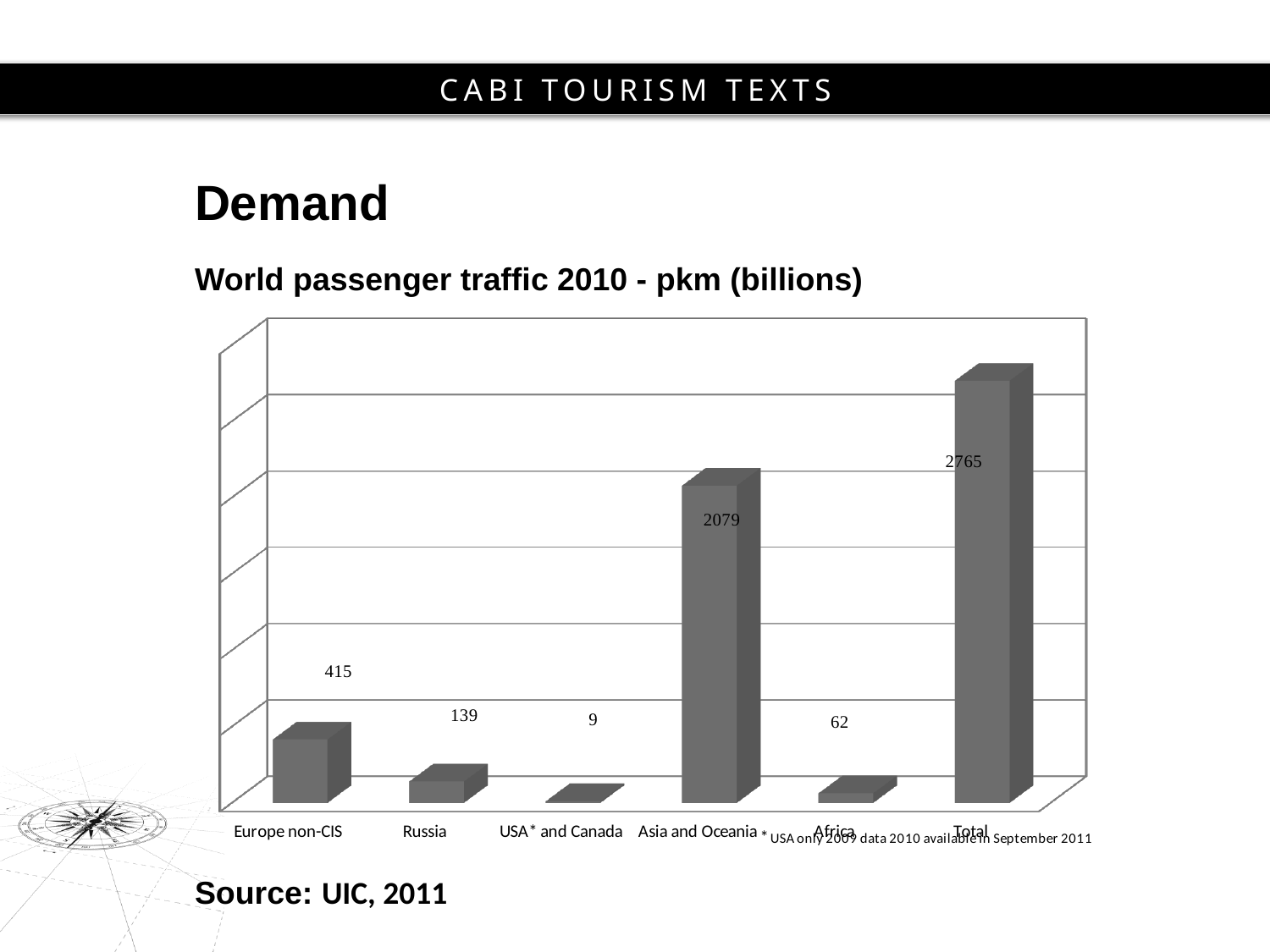
What is the value for Europe non-CIS? 415 Which category has the lowest value? USA* and Canada What is the value for Africa? 62 What is the title of the chart? World passenger traffic 2010 - pkm (billions) How many bars are shown in the chart? 6 What type of chart is shown on the slide? Bar chart Excluding the Total bar, which region has the highest value? Asia and Oceania Which is larger, the value for Russia or the value for Africa? Russia What is the value for Asia and Oceania? 2079 What is the difference between the values for Europe non-CIS and Russia? 276 What is the value shown for the Total bar? 2765 What is the value for Russia? 139